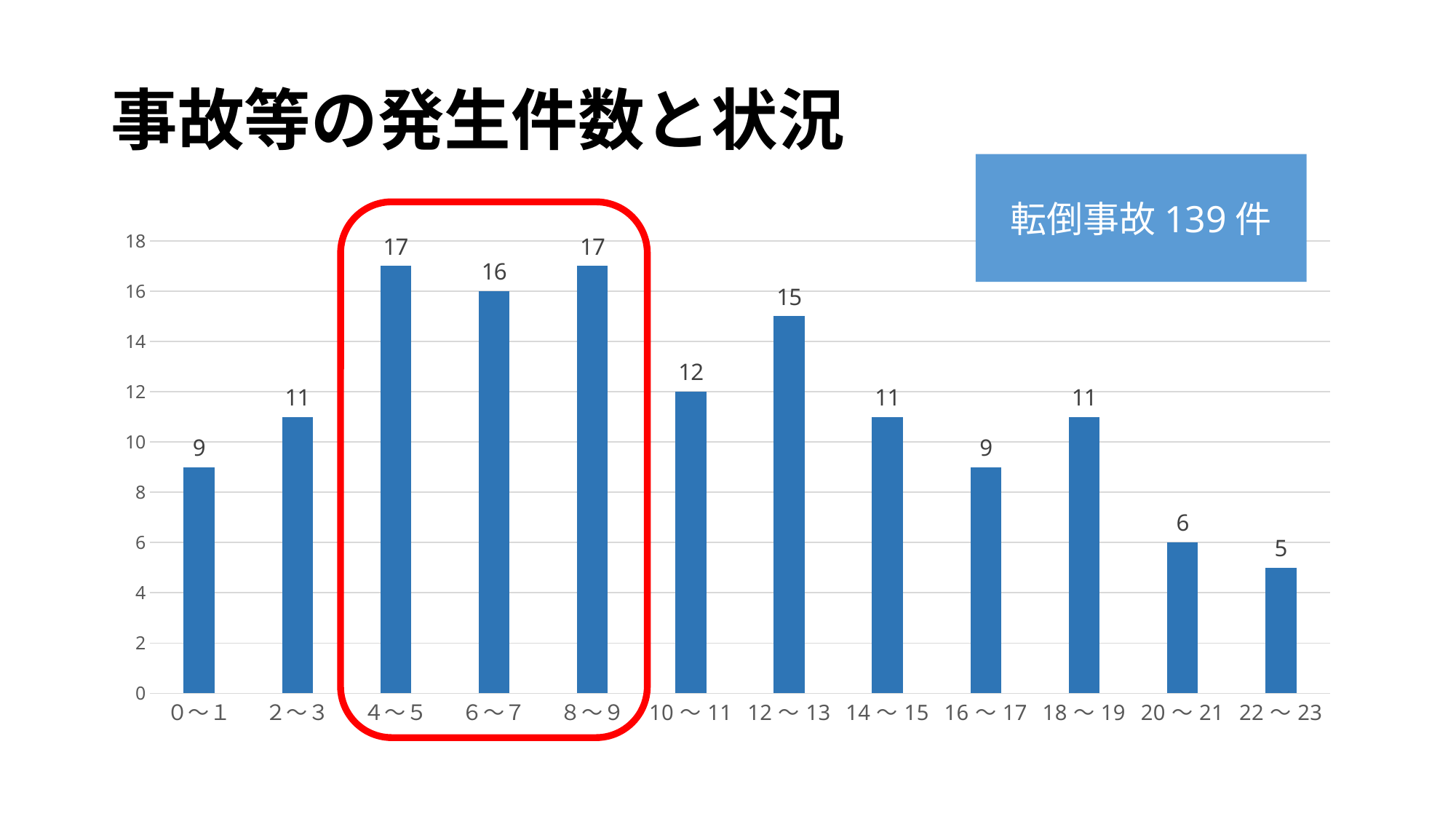
Is the value for 12〜13 greater or less than 14? greater Which category has the lowest value? 22〜23 What number is shown in the blue box at the top right of the slide? 139 What kind of chart is shown on the slide? bar chart How many categories are shown on the x axis? 12 What is the value for the 6〜7 category? 16 What is the highest value shown in the chart? 17 What is the value for the 22〜23 category? 5 Which is larger, the value for 2〜3 or the value for 16〜17? 2〜3 What is the difference between the values for 12〜13 and 20〜21? 9 What is the difference between the values for 4〜5 and 10〜11? 5 What is the value for the 12〜13 category? 15